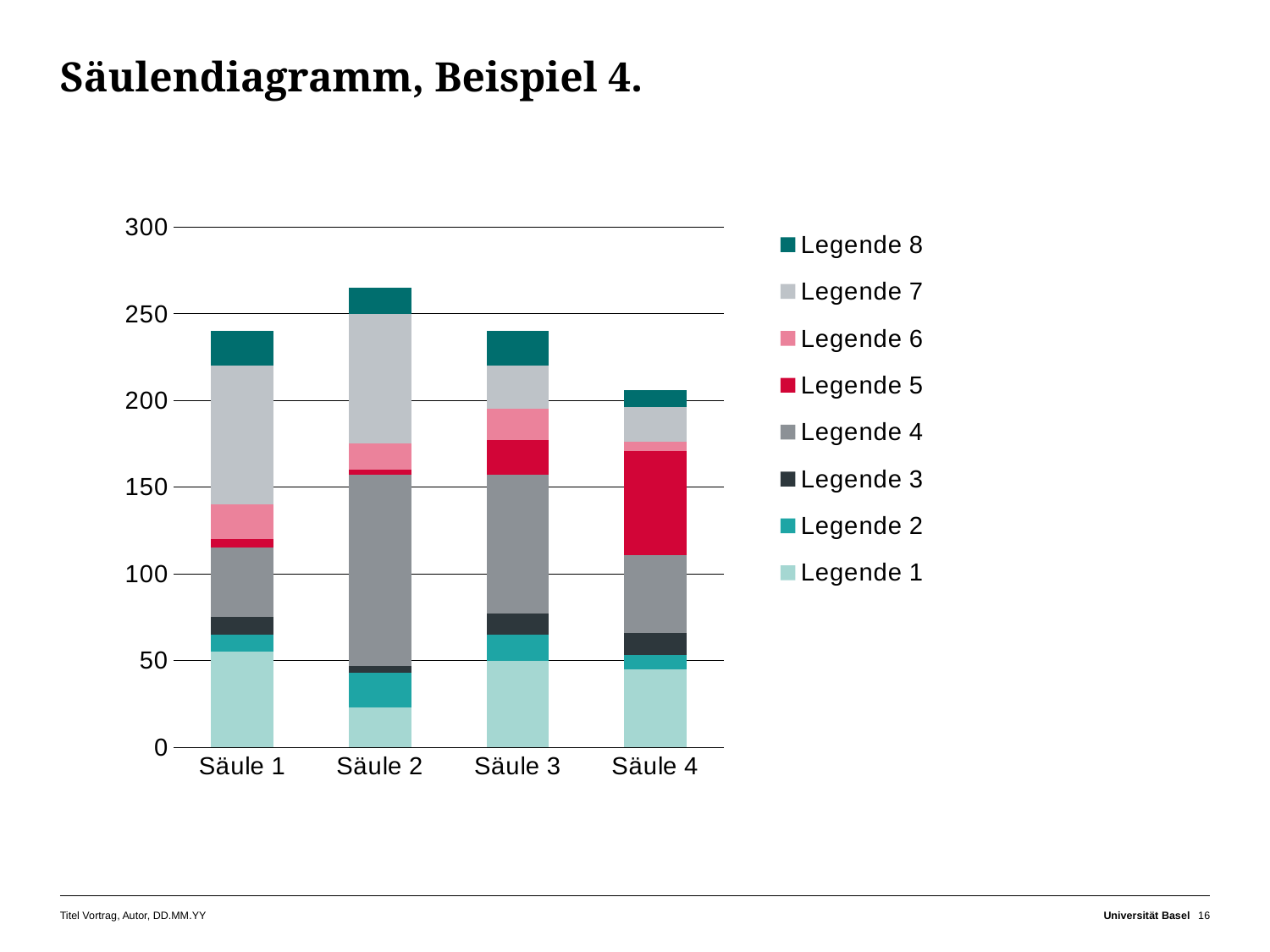
Which is larger: the Legende 5 segment in Säule 4 or the Legende 5 segment in Säule 1? Säule 4 Is the total of the stacked bar for Säule 4 greater or less than 250? less Is the total of the stacked bar for Säule 1 greater or less than 200? greater Which is larger: the Legende 7 segment in Säule 1 or the Legende 7 segment in Säule 4? Säule 1 How many series does the legend list? 8 Is the total of the stacked bar for Säule 2 greater or less than 250? greater Which category has the lowest total stacked bar? Säule 4 What kind of chart is shown on the slide? Stacked bar chart How many categories are shown on the x axis of the chart? 4 Which category has the highest total stacked bar? Säule 2 What is the title of the slide containing the chart? Säulendiagramm, Beispiel 4.